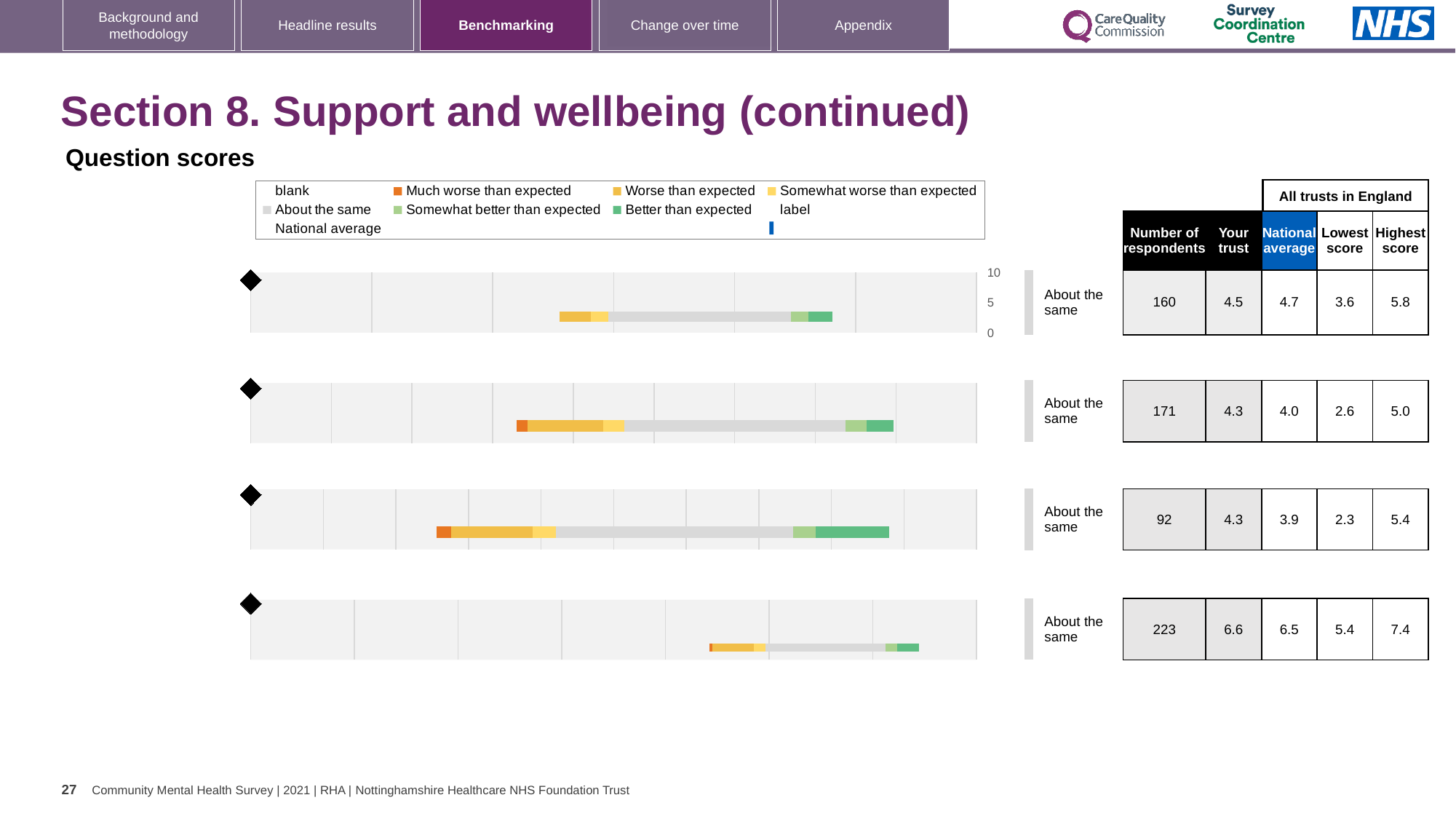
For the first (top) chart, what is the 'Your trust' score shown in the table? 4.5 For the fourth (bottom) chart, what is the highest score among all trusts in England? 7.4 For the first (top) chart, what is the national average score? 4.7 For the second chart from the top, what is the number of respondents? 171 How many benchmarking bar charts are shown on the slide? 4 What kind of chart is used to show the question scores on this slide? bar chart For the third chart from the top, what is the lowest score among all trusts in England? 2.3 For the second chart from the top, which is larger: the 'Your trust' score or the national average? Your trust (4.3) Which of the four charts has the highest 'Your trust' score? the fourth (bottom) chart, 6.6 For the first (top) chart, what is the difference between the highest score (5.8) and the lowest score (3.6)? 2.2 Which of the four charts has the fewest respondents? the third chart, 92 What benchmark category label is shown next to each of the four charts? About the same